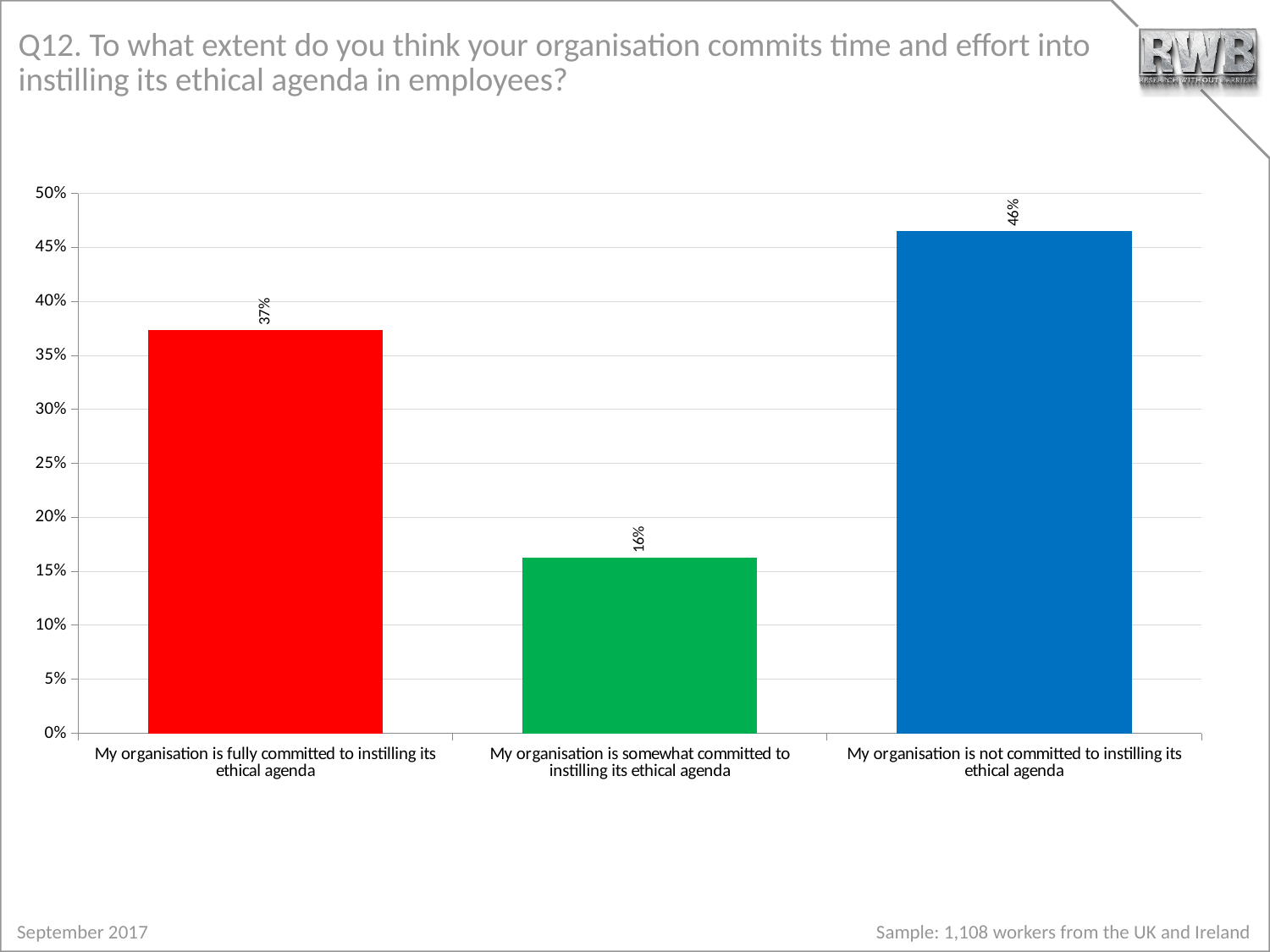
Which response has the highest percentage? My organisation is not committed to instilling its ethical agenda How many response categories are shown in the chart? 3 Which is larger: the percentage for 'fully committed' or for 'somewhat committed'? Fully committed Is the value for 'not committed' greater or less than 45%? greater What percentage of respondents said their organisation is somewhat committed to instilling its ethical agenda? 16% Which response has the lowest percentage? My organisation is somewhat committed to instilling its ethical agenda What is the difference in percentage points between 'not committed' and 'fully committed'? 9 percentage points What percentage of respondents said their organisation is fully committed to instilling its ethical agenda? 37% What type of chart is shown on the slide? Bar chart What colour is the bar for 'My organisation is not committed to instilling its ethical agenda'? Blue What percentage of respondents said their organisation is not committed to instilling its ethical agenda? 46% What is the difference in percentage points between 'fully committed' and 'somewhat committed'? 21 percentage points